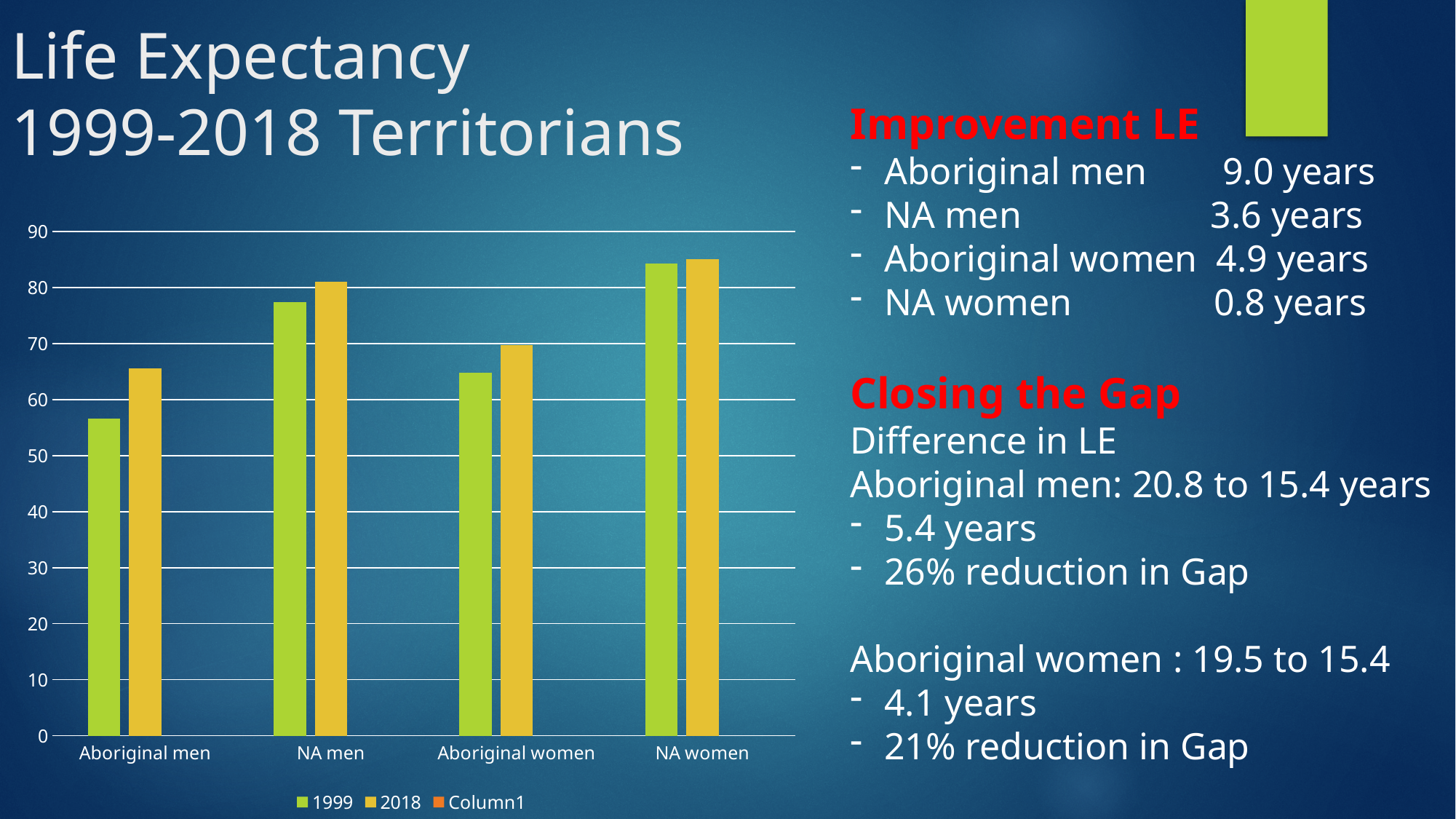
How many categories are shown on the x axis of the chart? 4 Which category has the highest 2018 bar in the chart? NA women How many series does the chart legend list? 3 Is the 1999 value for Aboriginal men greater or less than 60? less What colour are the 1999 bars in the chart? green For each category, is the 2018 bar higher or lower than the 1999 bar? higher Is the 1999 value for NA men greater or less than 70? greater Which category has the lowest 1999 bar in the chart? Aboriginal men Is the 1999 value for NA women greater or less than 80? greater Which is larger in 1999: the value for NA men or the value for Aboriginal women? NA men What kind of chart is shown on the slide? bar chart